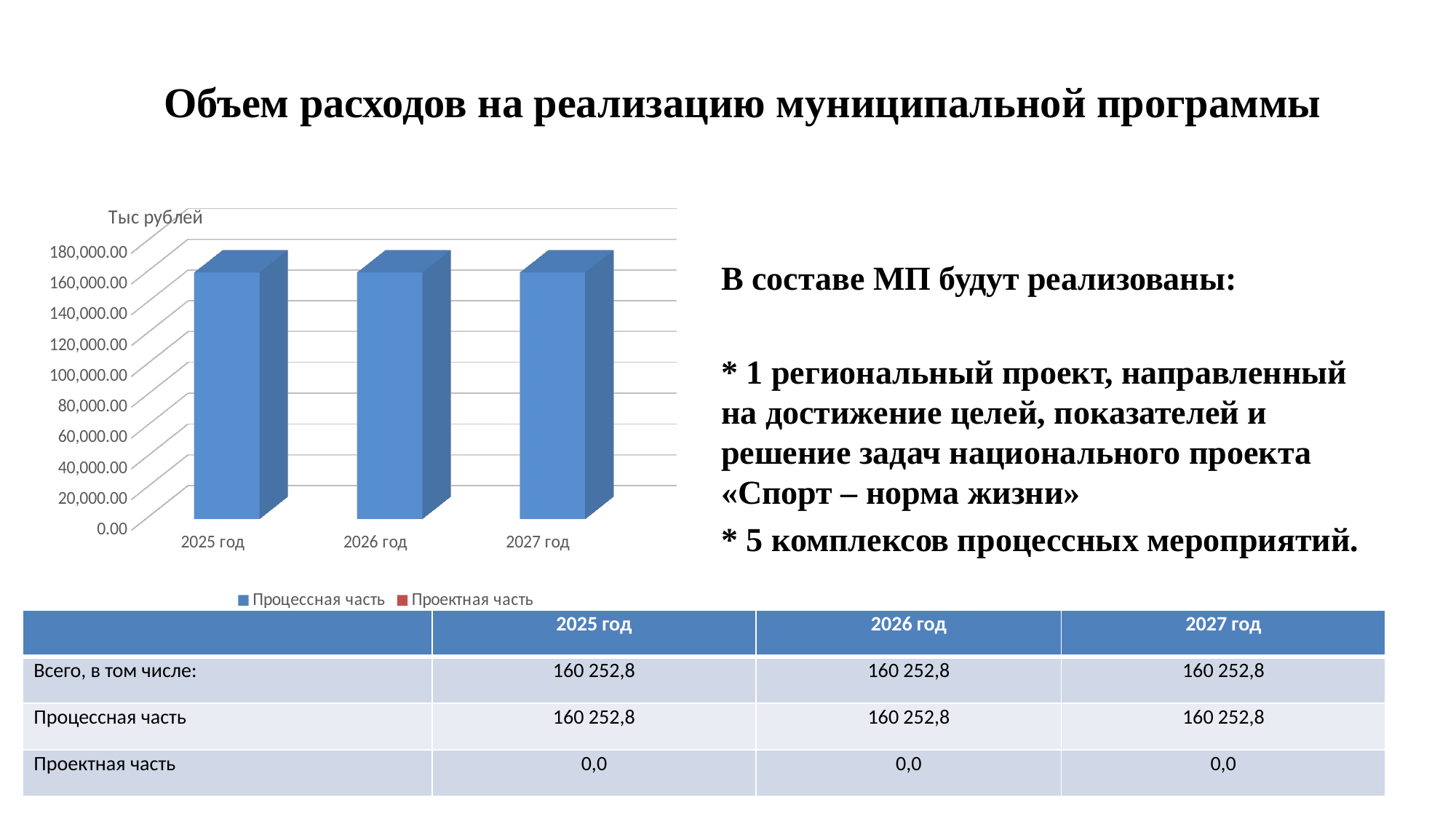
How many years (categories) are shown on the x axis of the chart? 3 How many series does the chart legend list? 2 What type of chart is shown on the slide? bar chart According to the table below the chart, what is the value of Процессная часть for 2026 год? 160 252,8 Is the value for 2026 год greater or less than 100,000.00? greater What are the two series named in the chart legend? Процессная часть, Проектная часть According to the table below the chart, what is the value of Проектная часть for 2025 год? 0,0 What is the difference between the Процессная часть values for 2025 год and 2027 год? 0,0 Is the value for 2027 год greater or less than 180,000.00? less Do the bar values rise, fall, or stay the same from 2025 год to 2027 год? stay the same What unit label is shown at the top of the chart's vertical axis? Тыс рублей Is the value for 2025 год greater or less than 140,000.00? greater